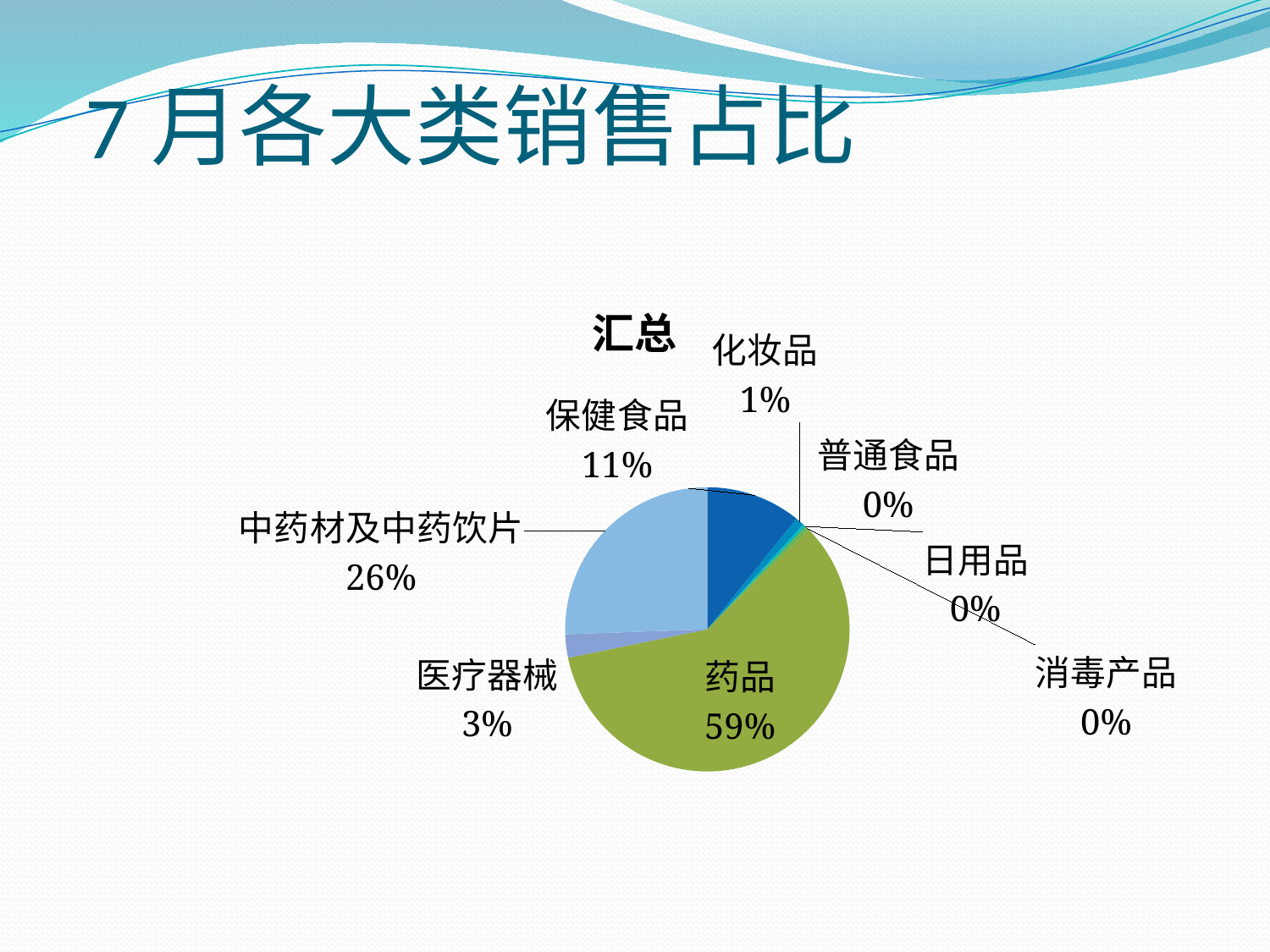
What is the difference in percentage points between 药品 and 中药材及中药饮片? 33 Which has a larger share, 保健食品 or 医疗器械? 保健食品 What share of the pie does 化妆品 have? 1% What is the combined share of 保健食品 and 中药材及中药饮片? 37% What is the title of the chart? 汇总 What share of the pie does 中药材及中药饮片 have? 26% What share of the pie does 医疗器械 have? 3% What share of the pie does 药品 have? 59% How many categories are shown in the pie chart? 8 What kind of chart is shown on the slide? pie chart What share of the pie does 保健食品 have? 11% Which category has the largest share of the pie? 药品